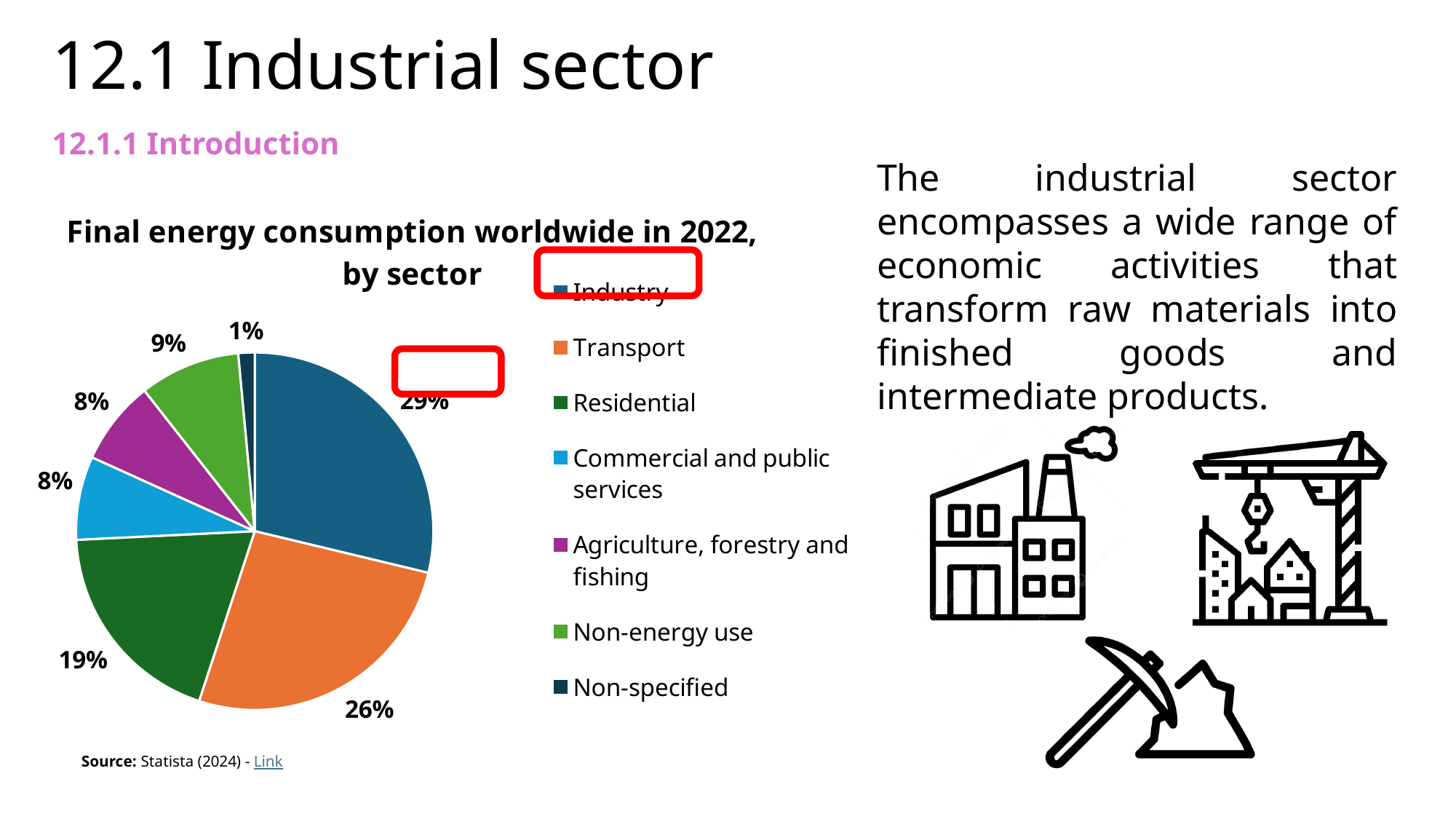
What share of final energy consumption does Residential account for? 19% How many sectors are listed in the chart legend? 7 What is the difference in percentage points between the Industry and Transport shares? 3 What share of final energy consumption does Industry account for? 29% Which has a larger share, Residential or Non-energy use? Residential What share of final energy consumption does Non-energy use account for? 9% What is the title of the chart? Final energy consumption worldwide in 2022, by sector What kind of chart is shown on the slide? pie chart What share of final energy consumption does Non-specified account for? 1% Which sector has the largest share of final energy consumption? Industry What share of final energy consumption does Transport account for? 26% Which sector has the smallest share of final energy consumption? Non-specified